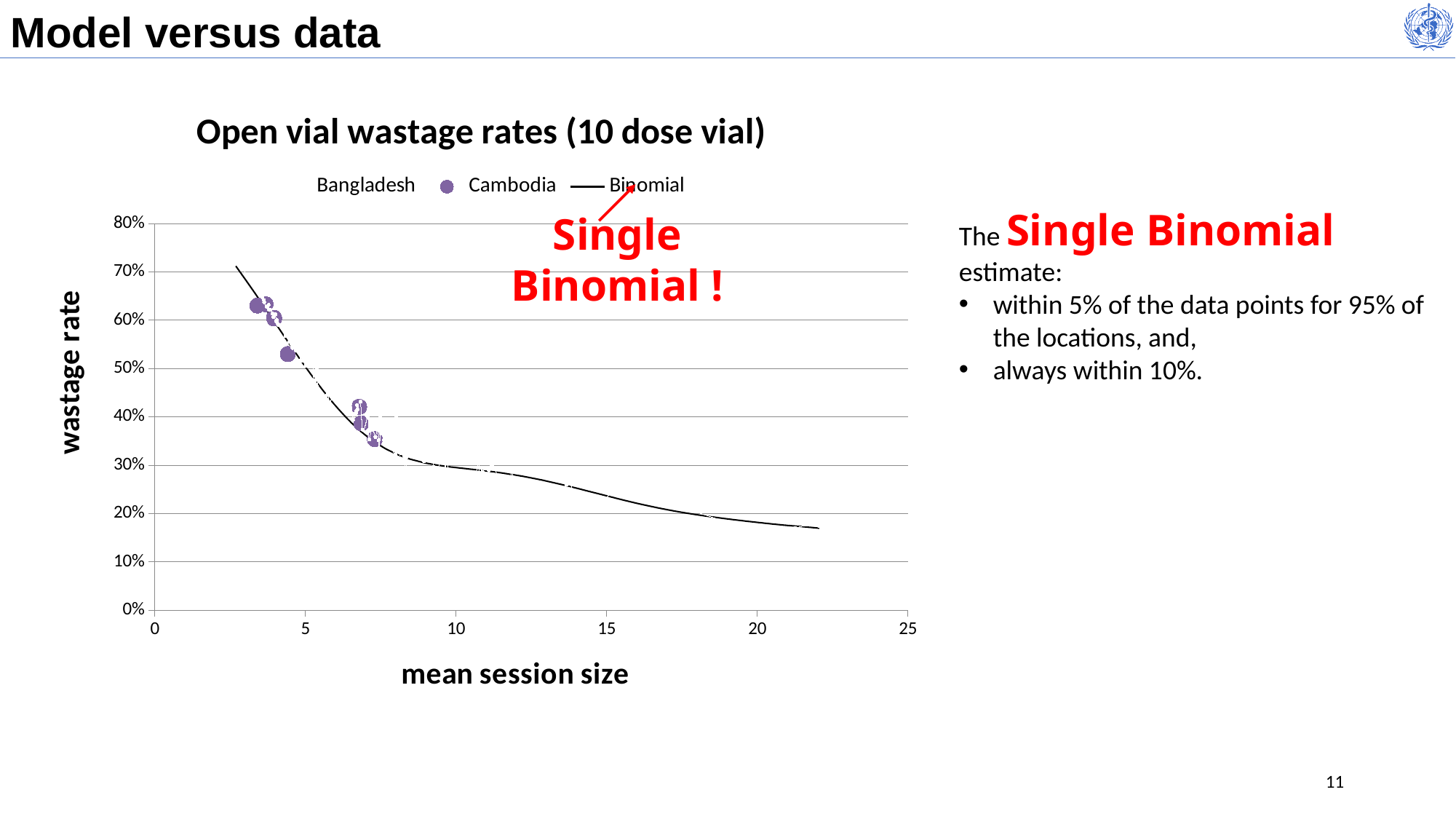
Does the wastage rate rise or fall as mean session size increases? fall How many series does the legend list? 3 What is the title of the chart? Open vial wastage rates (10 dose vial) What is the maximum value shown on the y axis? 80% Is the Binomial line value at a mean session size of 15 greater or less than 20%? greater What kind of chart is shown on the slide? scatter chart with a fitted line What is the label of the x axis? mean session size Is the Binomial line value at a mean session size of 20 greater or less than 30%? less Is the Binomial line value at a mean session size of 5 greater or less than 40%? greater